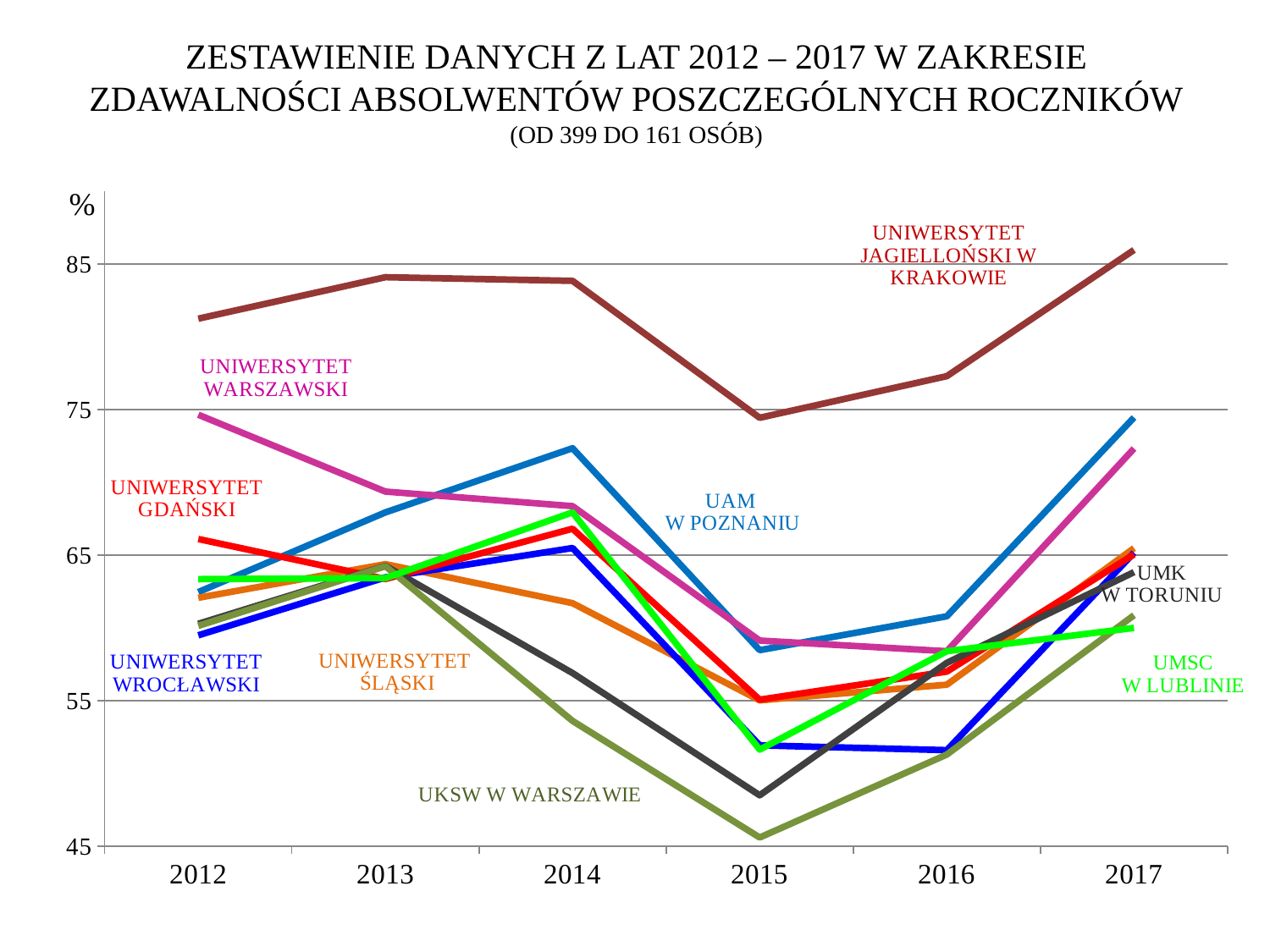
Which university has the lowest value in 2015? UKSW w Warszawie How many years are shown on the x axis of the chart? 6 Is the value for UKSW w Warszawie in 2015 greater or less than 55? less What kind of chart is shown on the slide? line chart Which university has the highest value in 2015? Uniwersytet Jagielloński w Krakowie Does the value for UKSW w Warszawie rise or fall from 2013 to 2015? fall How many universities (series) are plotted on the chart? 9 Does the value for Uniwersytet Jagielloński w Krakowie rise or fall from 2015 to 2017? rise Which university has the highest value in 2012? Uniwersytet Jagielloński w Krakowie Is the value for Uniwersytet Jagielloński w Krakowie in 2012 greater or less than 75? greater Is the value for UMK w Toruniu in 2015 greater or less than 55? less